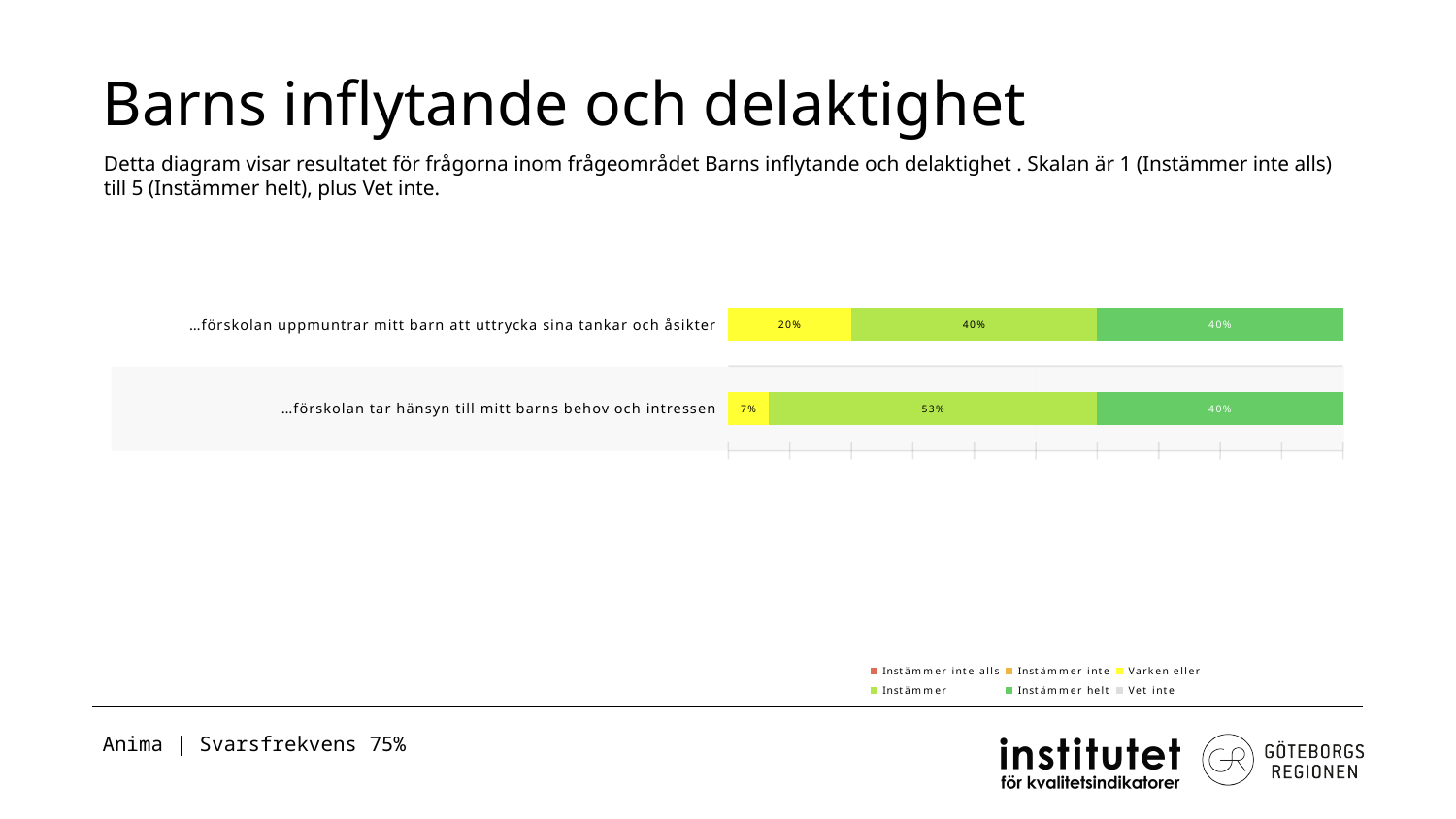
What is the 'Varken eller' value for '…förskolan tar hänsyn till mitt barns behov och intressen'? 7% What is the 'Instämmer' value for '…förskolan tar hänsyn till mitt barns behov och intressen'? 53% What is the 'Instämmer helt' value for '…förskolan uppmuntrar mitt barn att uttrycka sina tankar och åsikter'? 40% What is the difference between the 'Instämmer' values of the two categories? 13% What is the total of the labelled segments in the bar for '…förskolan tar hänsyn till mitt barns behov och intressen'? 100% What is the 'Varken eller' value for '…förskolan uppmuntrar mitt barn att uttrycka sina tankar och åsikter'? 20% What is the difference between the 'Varken eller' values of the two categories? 13% How many series does the legend list? 6 Which category has the lowest 'Varken eller' value? …förskolan tar hänsyn till mitt barns behov och intressen Which category has the higher 'Instämmer' value? …förskolan tar hänsyn till mitt barns behov och intressen How many categories (questions) are plotted in the chart? 2 What kind of chart is shown on the slide? Stacked bar chart